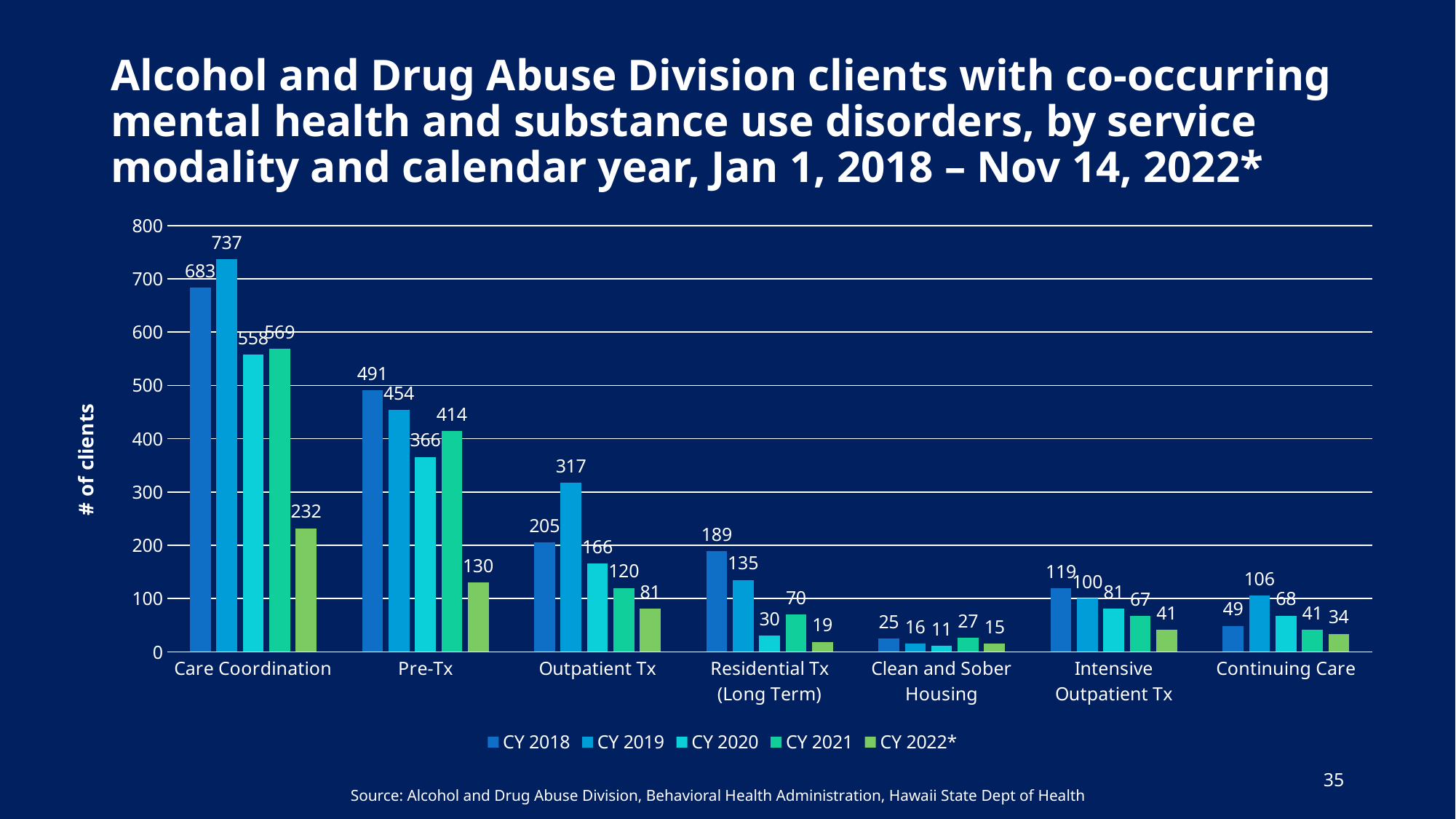
What is the number of clients for Clean and Sober Housing in CY 2020? 11 How many service modality categories are shown on the x axis? 7 What is the difference between the CY 2019 and CY 2018 values for Outpatient Tx? 112 Which is larger for Continuing Care: the CY 2019 value or the CY 2018 value? CY 2019 Which service modality has the lowest number of clients in CY 2022*? Clean and Sober Housing Which service modality has the highest number of clients in CY 2018? Care Coordination What is the number of clients for Care Coordination in CY 2019? 737 How many series does the legend list? 5 What is the label of the y axis? # of clients Do the values for Residential Tx (Long Term) rise or fall from CY 2018 to CY 2020? Fall What is the number of clients for Pre-Tx in CY 2021? 414 What kind of chart is shown on the slide? Bar chart